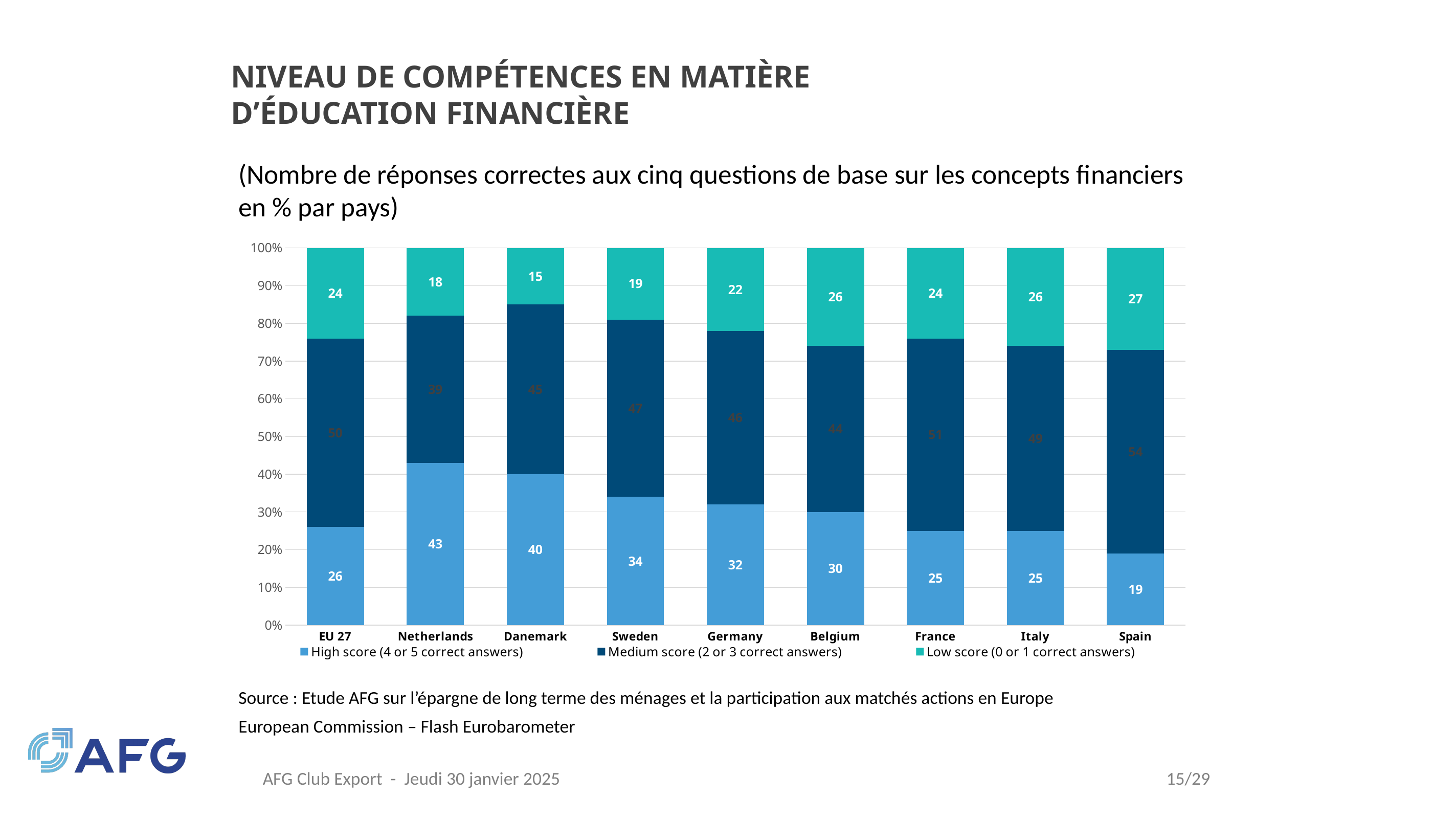
Which country has the lowest Low score (0 or 1 correct answers) value? Danemark Which country has the highest High score (4 or 5 correct answers) value? Netherlands What is the Low score (0 or 1 correct answers) value for Danemark? 15 Which has a larger High score (4 or 5 correct answers) value, Sweden or Germany? Sweden How many countries/categories are shown on the x axis? 9 Which country has the lowest High score (4 or 5 correct answers) value? Spain Which legend entry is shown in light blue? High score (4 or 5 correct answers) What is the High score (4 or 5 correct answers) value for Netherlands? 43 How many series does the legend list? 3 What is the difference between the High score values for Netherlands and Spain? 24 What is the Low score (0 or 1 correct answers) value for France? 24 What kind of chart is shown on the slide? Stacked bar chart